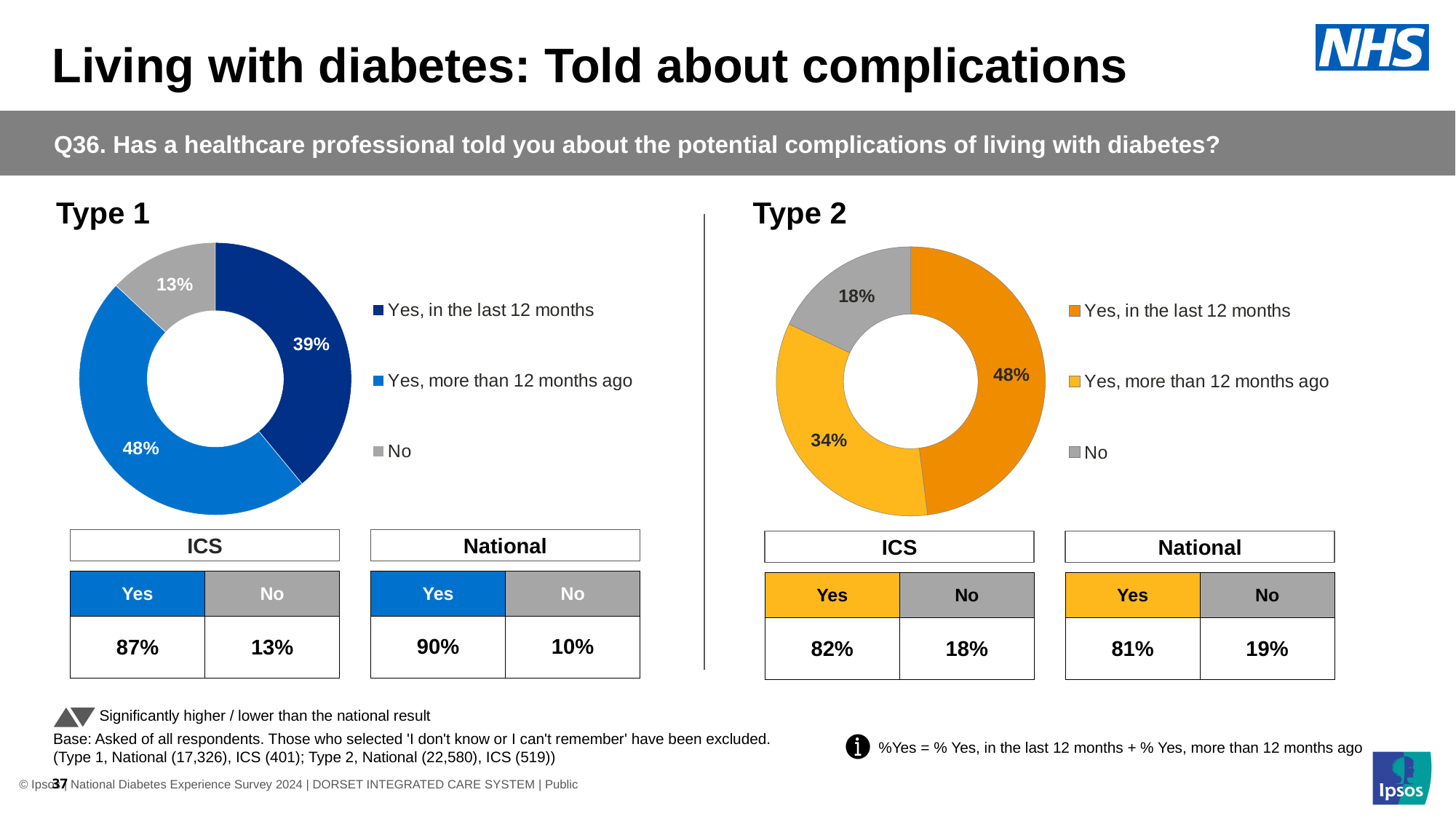
What colour represents 'No' in the Type 2 chart? Grey How many categories does the Type 2 chart show? 3 In the Type 2 chart, which category has the smallest share? No What kind of chart is used for Type 1? Donut (pie) chart In the Type 2 chart, what is the difference between the 'Yes, in the last 12 months' share and the 'Yes, more than 12 months ago' share? 14 percentage points Which is larger in the Type 1 chart: the 'Yes, in the last 12 months' share or the 'No' share? Yes, in the last 12 months In the Type 1 chart, what percentage of respondents said 'Yes, in the last 12 months'? 39% In the Type 2 chart, what percentage of respondents said 'Yes, in the last 12 months'? 48% In the Type 1 chart, which category has the largest share? Yes, more than 12 months ago In the Type 1 chart, what is the difference between the 'Yes, more than 12 months ago' share and the 'No' share? 35 percentage points In the Type 1 chart, what percentage of respondents said 'Yes, more than 12 months ago'? 48% In the Type 2 chart, what percentage of respondents said 'No'? 18%